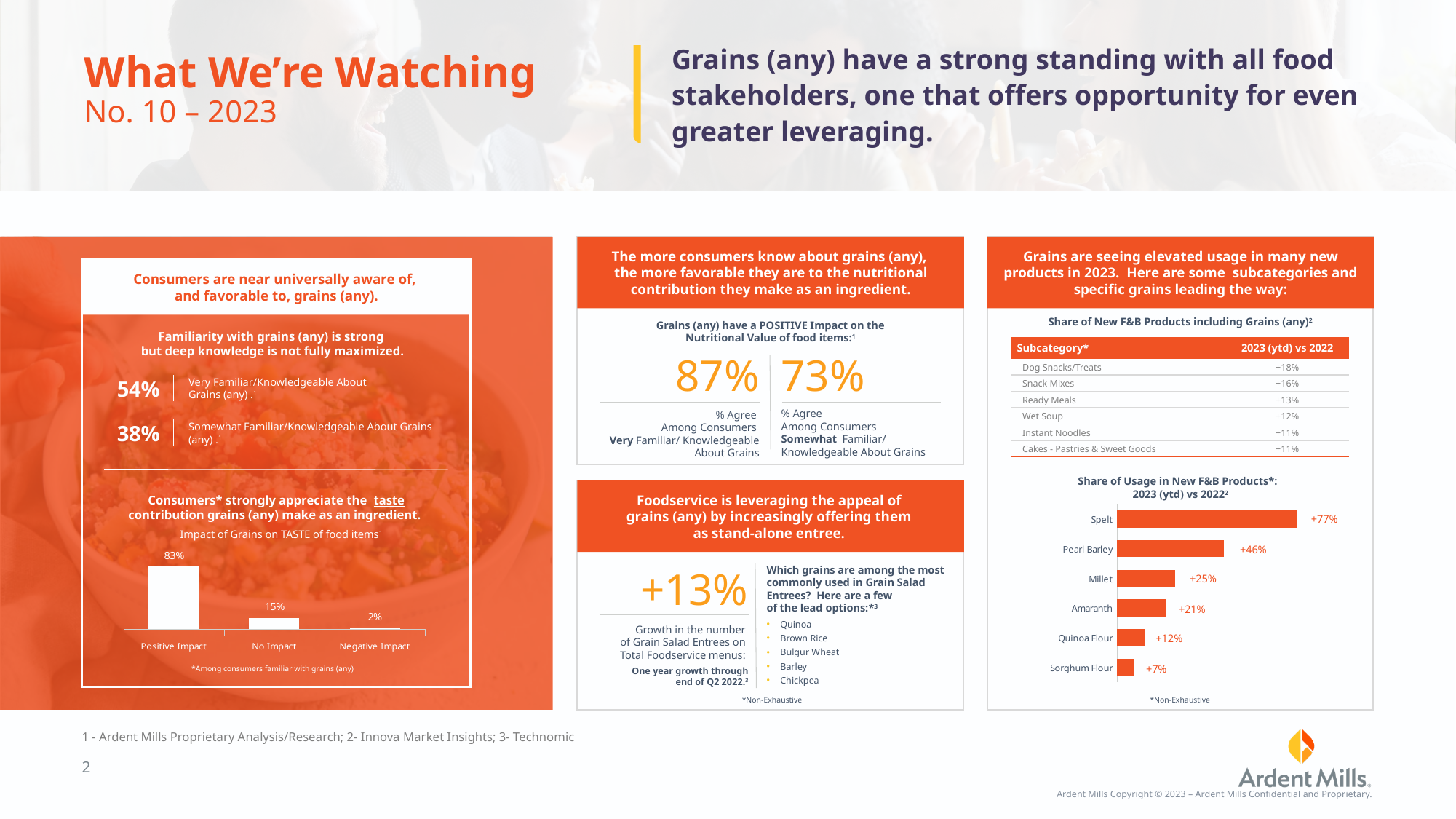
In the 'Impact of Grains on TASTE of food items' chart, which category has the lowest value? Negative Impact In the 'Share of Usage in New F&B Products: 2023 (ytd) vs 2022' chart, what is the value for Spelt? +77% In the 'Share of Usage in New F&B Products: 2023 (ytd) vs 2022' chart, how many grains are shown? 6 In the 'Impact of Grains on TASTE of food items' chart, what is the value for Positive Impact? 83% In the 'Impact of Grains on TASTE of food items' chart, what is the difference between Positive Impact and No Impact? 68% In the 'Share of Usage in New F&B Products: 2023 (ytd) vs 2022' chart, which grain has the lowest value? Sorghum Flour In the 'Impact of Grains on TASTE of food items' chart, what is the value for No Impact? 15% In the 'Share of Usage in New F&B Products: 2023 (ytd) vs 2022' chart, what is the difference between Spelt and Pearl Barley? 31% What kind of chart is the 'Impact of Grains on TASTE of food items' chart? Bar chart In the 'Share of Usage in New F&B Products: 2023 (ytd) vs 2022' chart, what is the value for Amaranth? +21% In the 'Impact of Grains on TASTE of food items' chart, how many categories are shown? 3 In the 'Share of Usage in New F&B Products: 2023 (ytd) vs 2022' chart, which is larger, Millet or Quinoa Flour? Millet